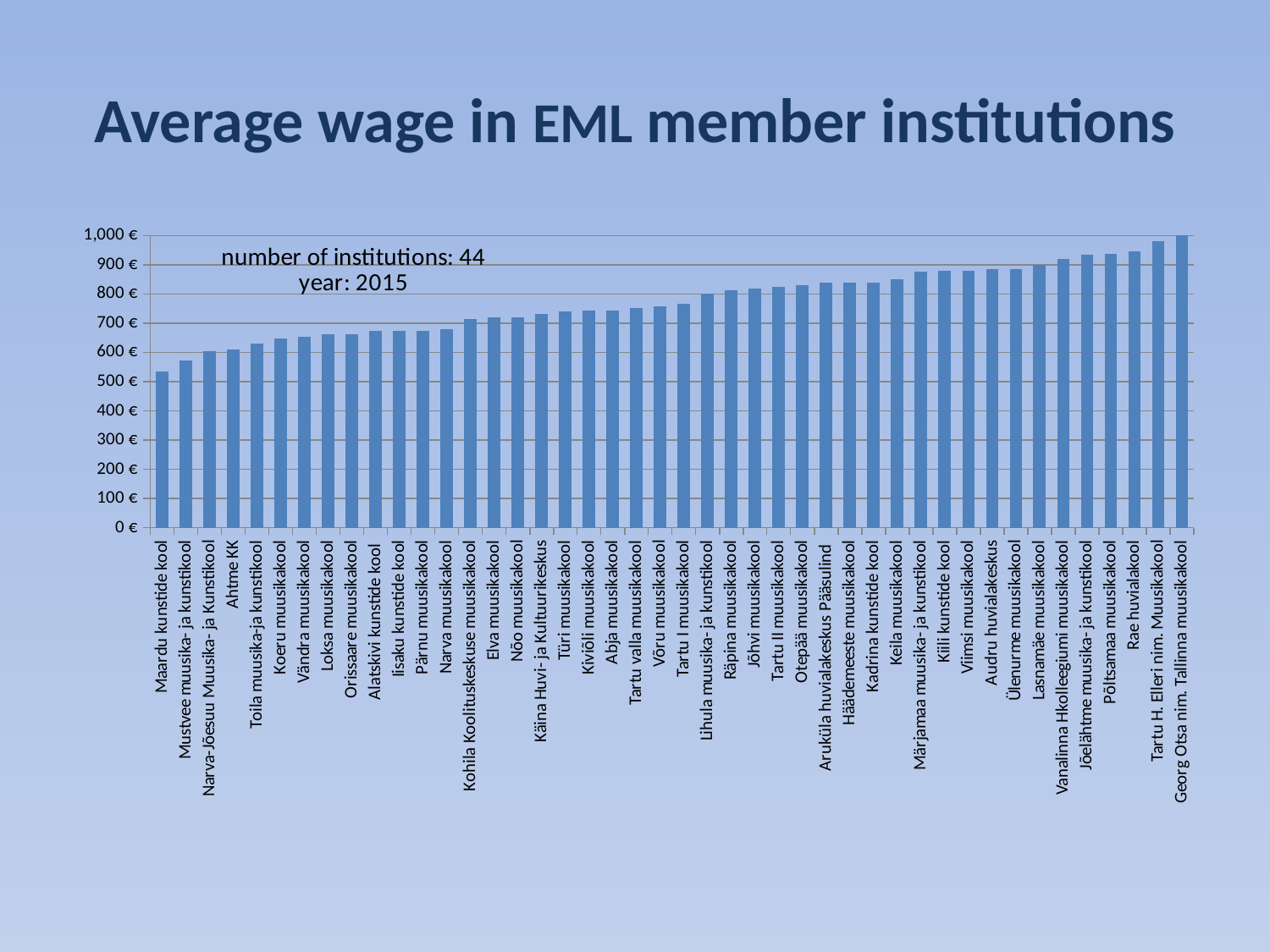
Which year does the chart's data refer to, according to the note on the chart? 2015 Is the value for Keila muusikakool greater or less than 800 €? greater Is the value for Mustvee muusika- ja kunstikool greater or less than 600 €? less Which has the larger average wage, Narva muusikakool or Tartu I muusikakool? Tartu I muusikakool What kind of chart is shown on the slide? bar chart Which institution has the lowest average wage? Maardu kunstide kool Do the bars rise or fall from left to right along the x axis? rise Is the value for Georg Otsa nim. Tallinna muusikakool greater or less than 900 €? greater Which institution has the highest average wage? Georg Otsa nim. Tallinna muusikakool How many institutions are shown in the chart? 44 What is the title of the chart? Average wage in EML member institutions